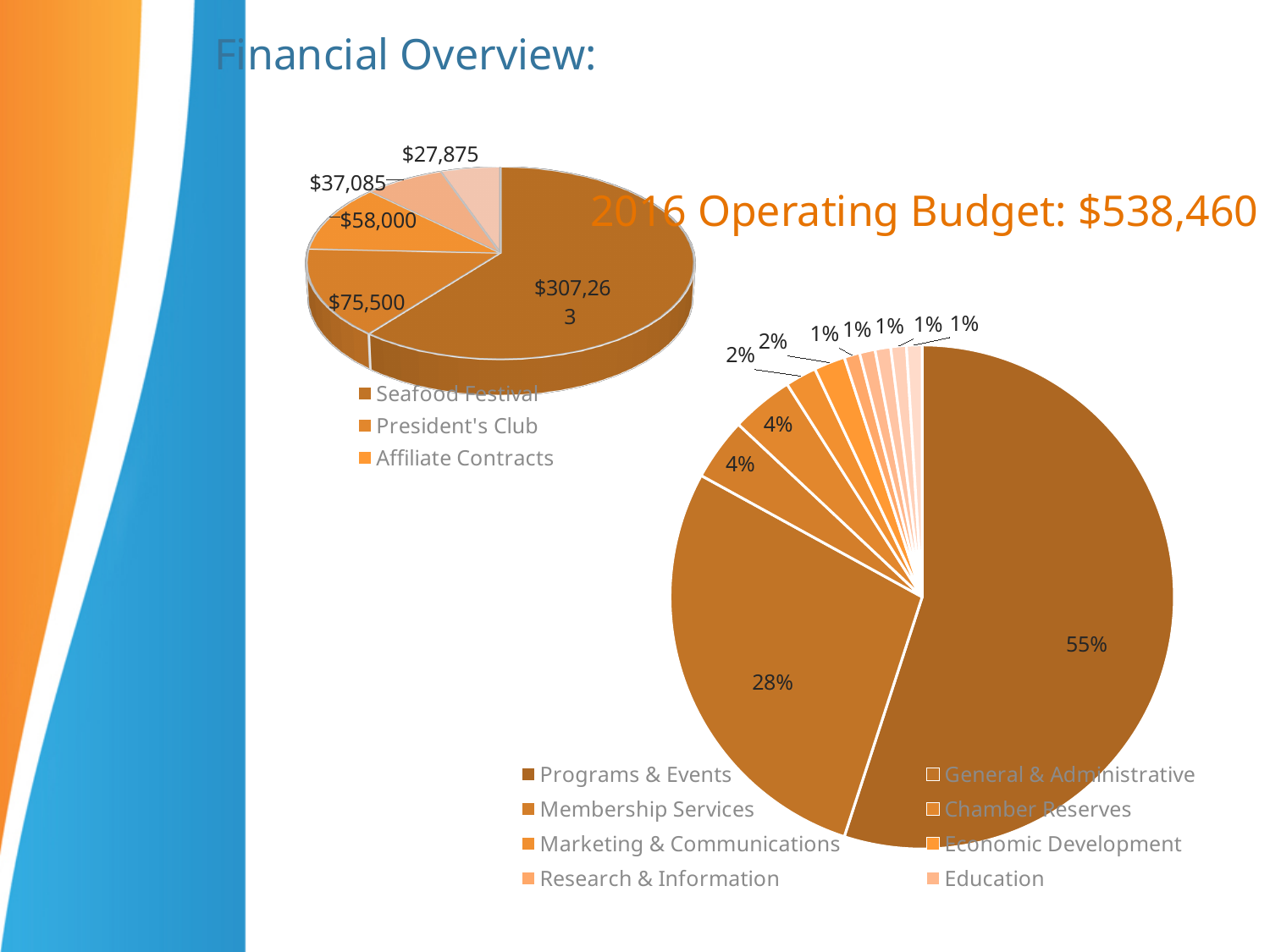
In the bottom-right pie chart, which is larger: Programs & Events or Membership Services? Programs & Events In the top-left pie chart, what is the value for Seafood Festival? $307,263 How many entries does the legend of the bottom-right pie chart list? 8 In the bottom-right pie chart, what share does Membership Services have? 4% In the top-left pie chart, what is the difference between the President's Club value and the Affiliate Contracts value? $17,500 In the top-left pie chart, what is the smallest labeled value? $27,875 In the bottom-right pie chart, what share does Programs & Events have? 55% In the top-left pie chart, what is the value for Affiliate Contracts? $58,000 What kind of chart is the chart in the top-left of the slide? pie chart In the top-left pie chart, what is the value for President's Club? $75,500 In the bottom-right pie chart, which category has the largest slice? Programs & Events How many slices does the top-left pie chart have? 5